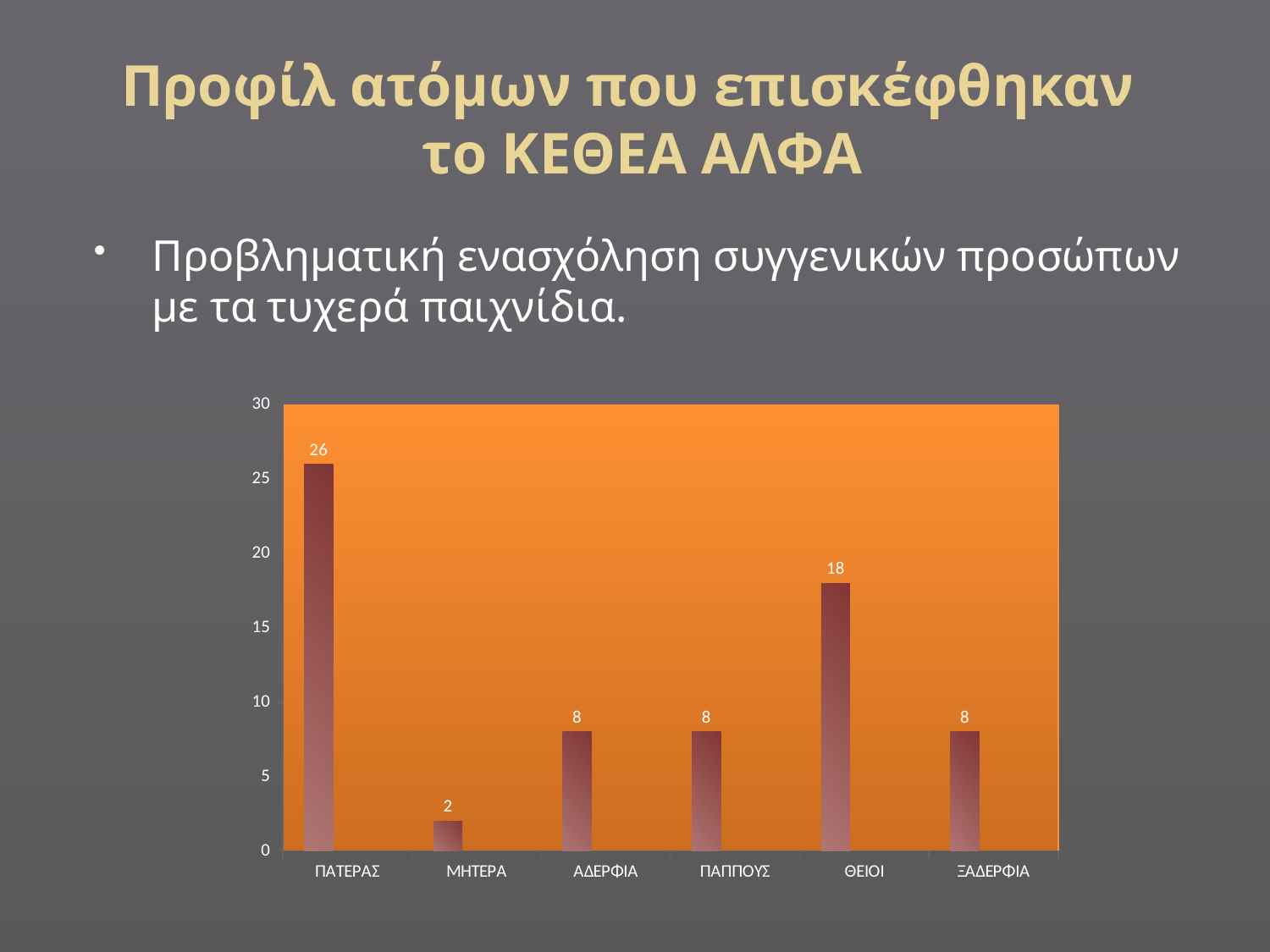
What is the difference between the values for ΠΑΤΕΡΑΣ and ΘΕΙΟΙ? 8 What is the value for ΞΑΔΕΡΦΙΑ? 8 How many categories are shown on the x axis? 6 Is the value for ΘΕΙΟΙ greater or less than 20? less Which is larger, the value for ΘΕΙΟΙ or the value for ΠΑΠΠΟΥΣ? ΘΕΙΟΙ How many categories have a value of 8? 3 What is the value for ΘΕΙΟΙ? 18 What is the value for ΜΗΤΕΡΑ? 2 What kind of chart is shown on the slide? bar chart Which category has the highest value? ΠΑΤΕΡΑΣ Which category has the lowest value? ΜΗΤΕΡΑ What is the value for ΠΑΤΕΡΑΣ? 26